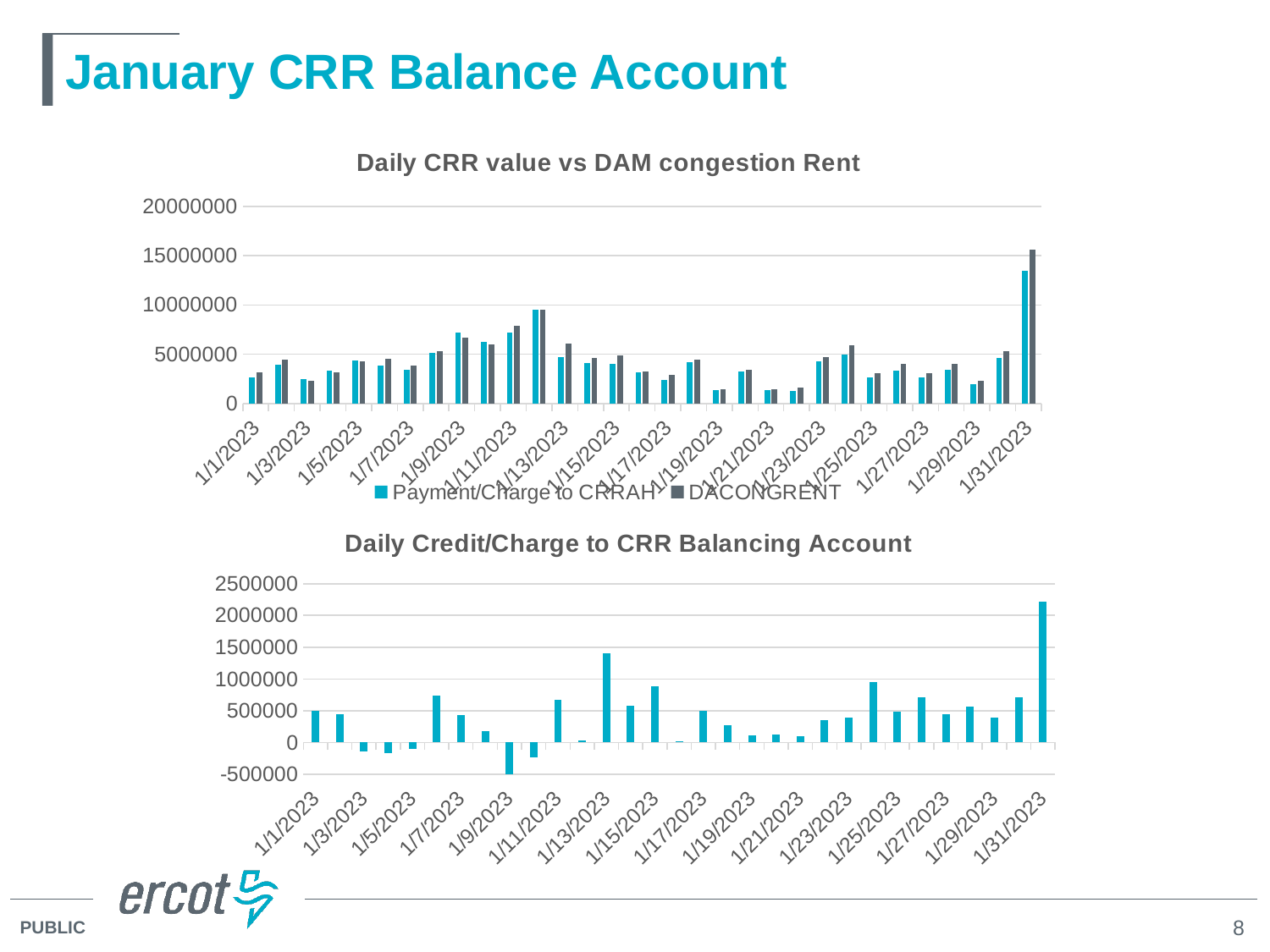
In the 'Daily CRR value vs DAM congestion Rent' chart, is the Payment/Charge to CRRAH value for 1/1/2023 greater or less than 5000000? less What are the two legend entries in the 'Daily CRR value vs DAM congestion Rent' chart? Payment/Charge to CRRAH and DACONGRENT What kind of chart is the 'Daily CRR value vs DAM congestion Rent' chart? bar chart In the 'Daily Credit/Charge to CRR Balancing Account' chart, which date has the highest value? 1/31/2023 What kind of chart is the 'Daily Credit/Charge to CRR Balancing Account' chart? bar chart In the 'Daily Credit/Charge to CRR Balancing Account' chart, is the value for 1/31/2023 greater or less than 2000000? greater In the 'Daily CRR value vs DAM congestion Rent' chart, which date has the highest DACONGRENT value? 1/31/2023 How many series does the legend of the 'Daily CRR value vs DAM congestion Rent' chart list? 2 In the 'Daily Credit/Charge to CRR Balancing Account' chart, which is larger: the value for 1/13/2023 or for 1/15/2023? 1/13/2023 In the 'Daily CRR value vs DAM congestion Rent' chart, is the DACONGRENT value for 1/31/2023 greater or less than 10000000? greater In the 'Daily Credit/Charge to CRR Balancing Account' chart, which date has the lowest value? 1/9/2023